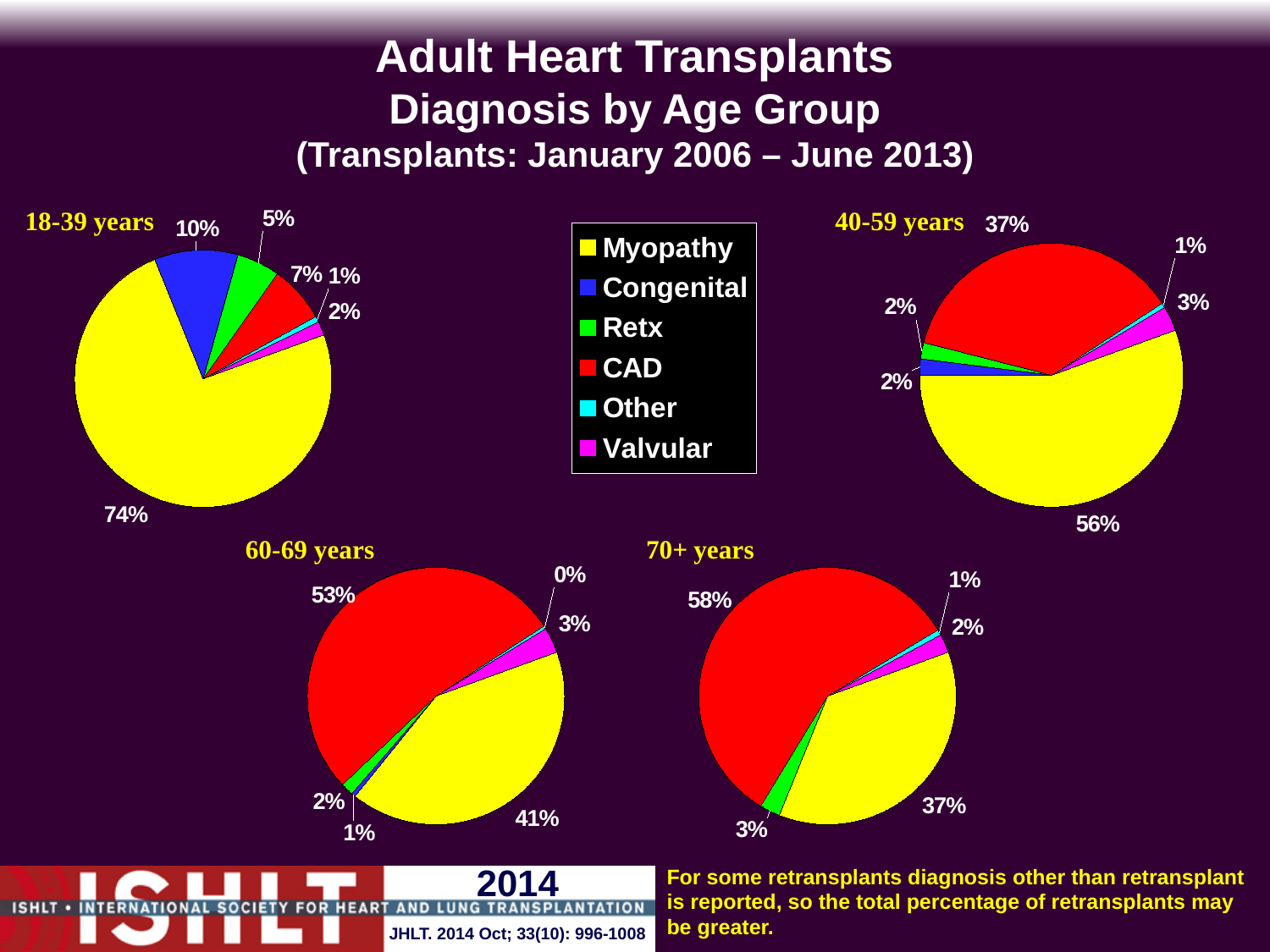
In the 60-69 years pie chart, what percentage is Myopathy? 41% In the 70+ years pie chart, which diagnosis has the largest share? CAD In the 18-39 years pie chart, what is the difference between the Myopathy and Congenital shares? 64% What kind of charts are shown on the slide? Pie charts How many series does the legend list? 6 In the 40-59 years pie chart, what percentage is CAD? 37% In the 40-59 years pie chart, which diagnosis has the largest share? Myopathy In the 60-69 years pie chart, which diagnosis has the smallest share? Other In the 18-39 years pie chart, what percentage is Myopathy? 74% In the 70+ years pie chart, what percentage is Retx? 3% In the 60-69 years pie chart, which is larger, CAD or Myopathy? CAD In the 18-39 years pie chart, what percentage is Congenital? 10%